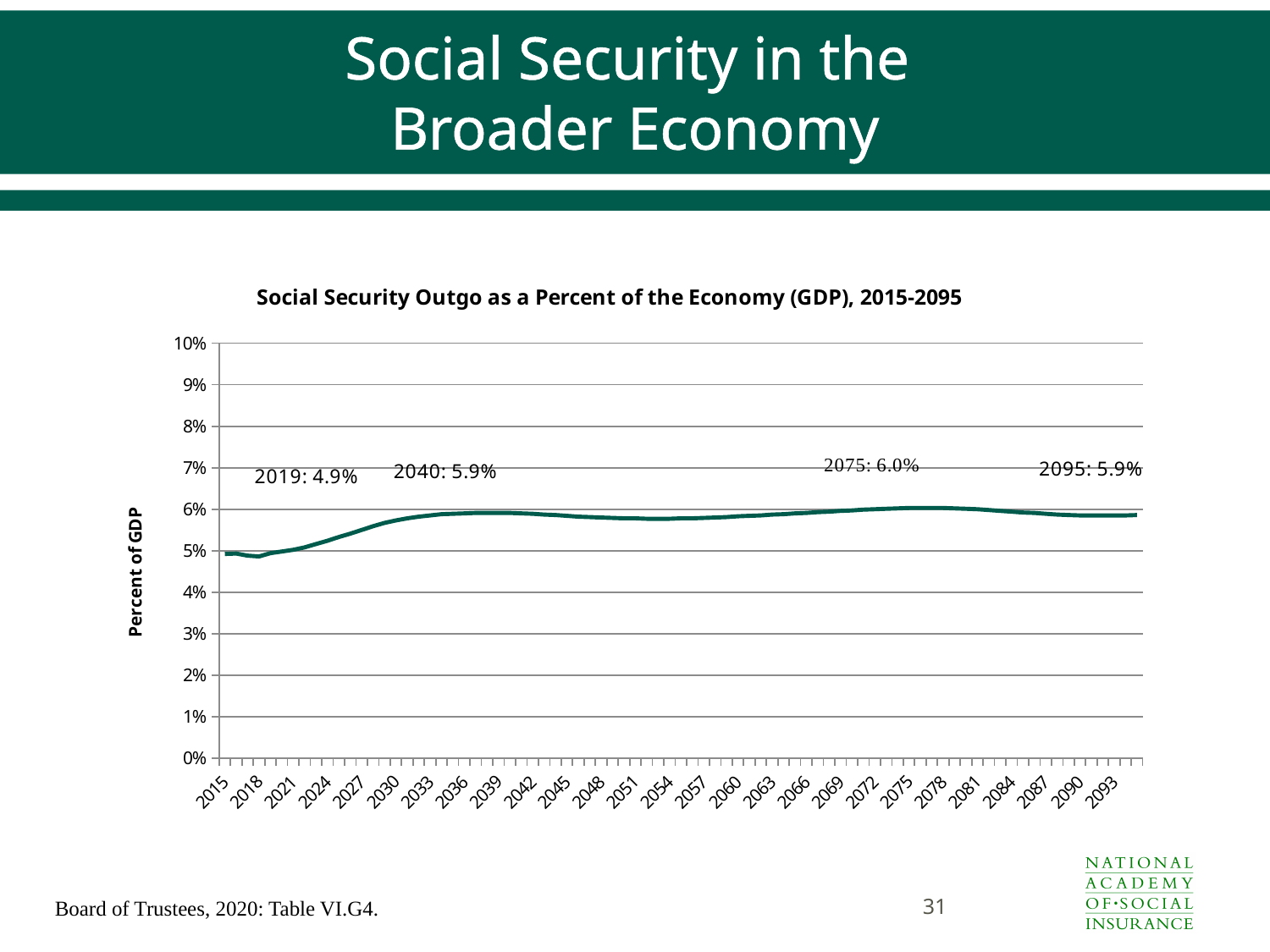
What is the Social Security outgo as a percent of GDP in 2019? 4.9% Is the outgo as a percent of GDP larger in 2075 or in 2019? 2075 Is the value for 2060 greater or less than 5%? greater What is the Social Security outgo as a percent of GDP in 2075? 6.0% What is the Social Security outgo as a percent of GDP in 2095? 5.9% What is the difference between the outgo as a percent of GDP in 2040 and in 2019? 1.0% Of the four labeled years, which has the lowest outgo as a percent of GDP? 2019 Is the value for 2018 greater or less than 6%? less What kind of chart is shown on the slide? Line chart Of the four labeled years, which has the highest outgo as a percent of GDP? 2075 What is the Social Security outgo as a percent of GDP in 2040? 5.9% What is the title of the chart? Social Security Outgo as a Percent of the Economy (GDP), 2015-2095